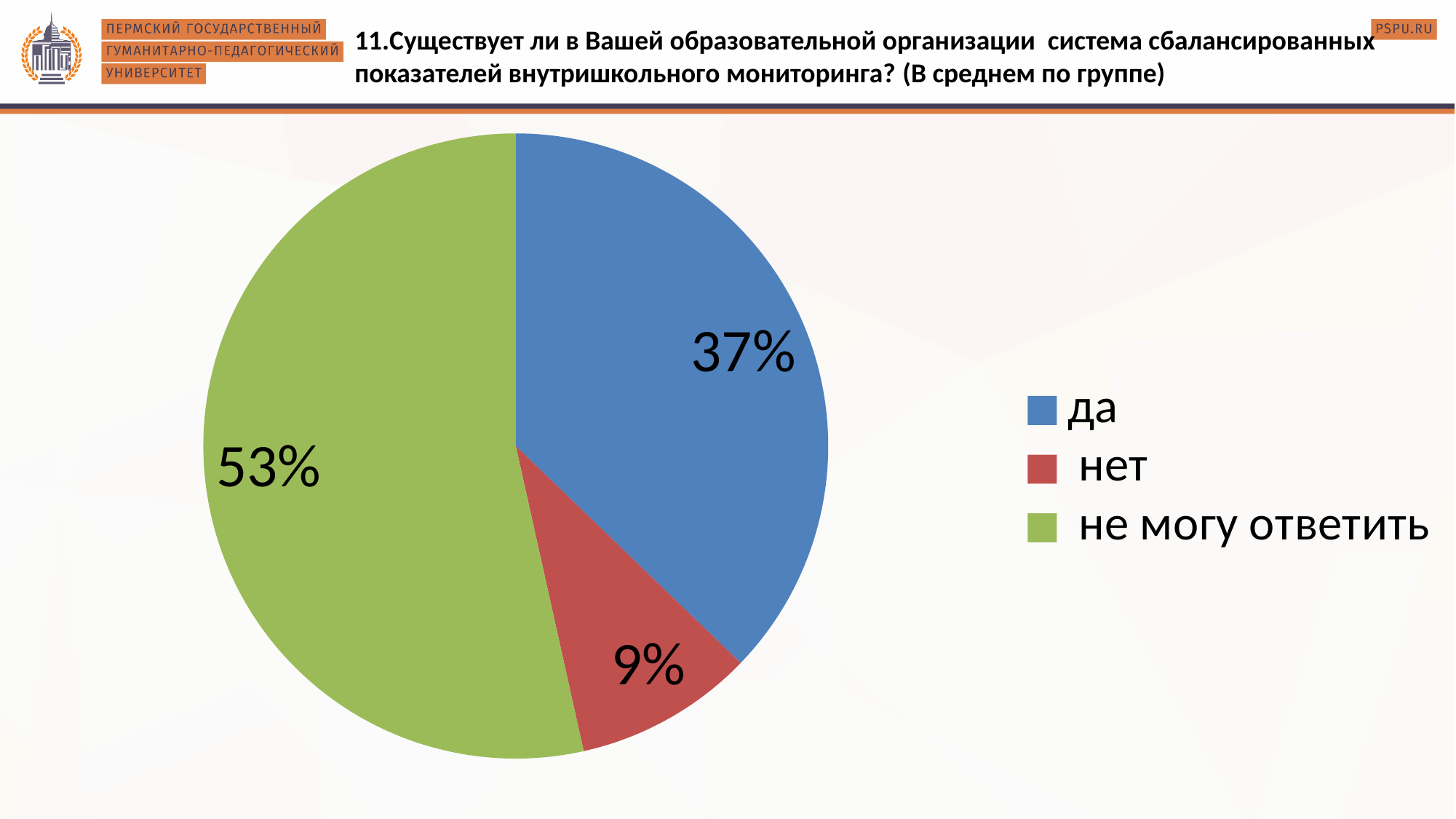
Which answer option has the largest share of the pie? не могу ответить What percentage of respondents answered "не могу ответить"? 53% What percentage of respondents answered "нет"? 9% What colour represents "не могу ответить" in the chart? green What is the difference in percentage points between "да" and "нет"? 28 What percentage of respondents answered "да"? 37% What is the difference in percentage points between "не могу ответить" and "да"? 16 What colour represents "да" in the chart? blue Which is larger, the share for "да" or the share for "нет"? да How many answer options are shown in the pie chart? 3 Which answer option has the smallest share of the pie? нет What type of chart is shown on the slide? pie chart